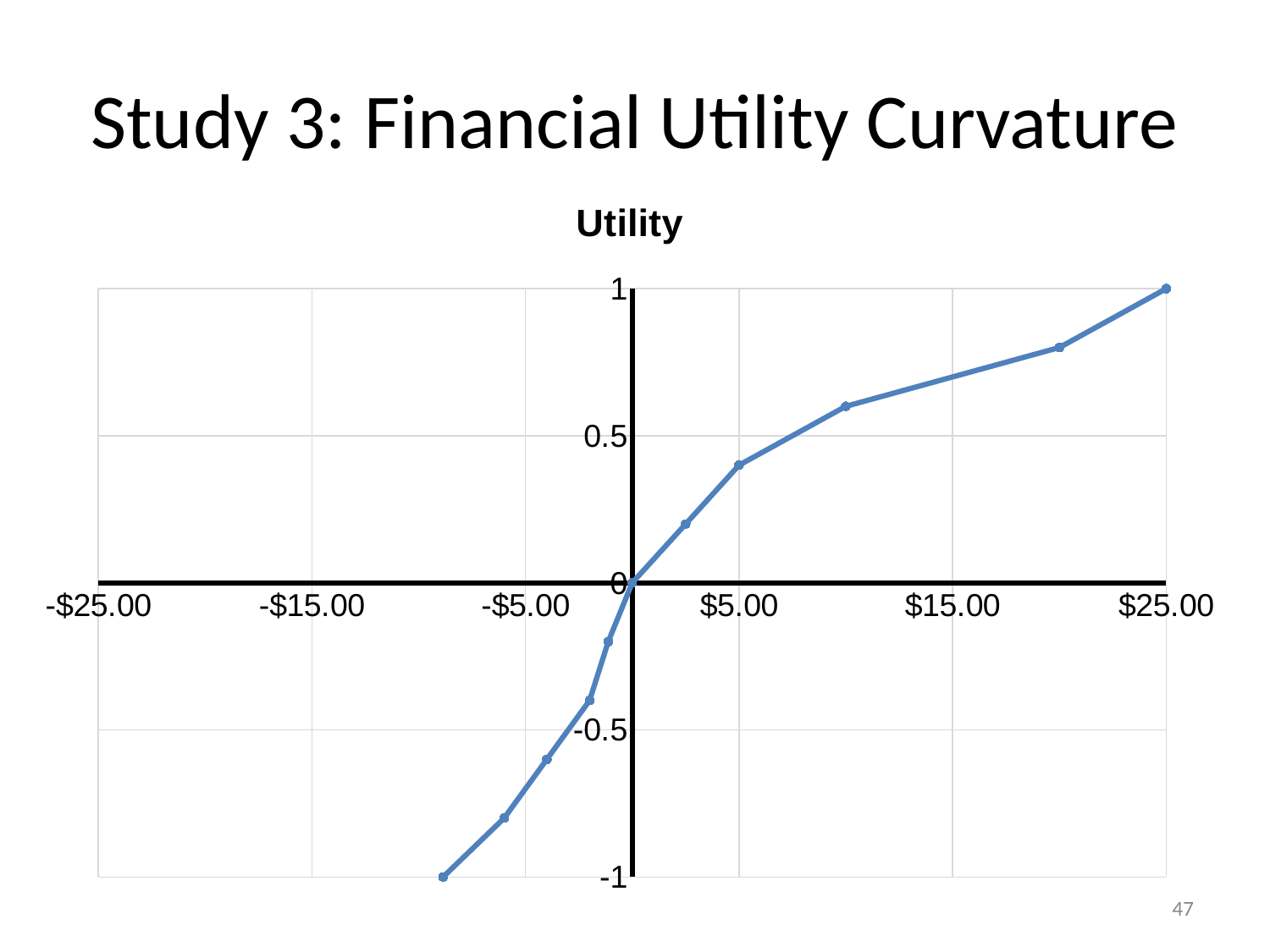
What is the lowest value shown on the x axis? -$25.00 What is the utility value at $0? 0 Is the utility value at $5.00 greater or less than 0.5? less Is the utility value at -$5.00 greater or less than -0.5? less What kind of chart is shown on the slide? line chart What is the utility value at $25.00? 1 At which x-axis value does the line reach its highest utility? $25.00 Does utility rise or fall as the dollar amount increases along the x axis? rises Which is larger, the utility at $5.00 or the utility at $25.00? $25.00 Is the utility value at $25.00 greater or less than 0.5? greater What is the title of the chart? Utility How many data points are plotted on the line? 11